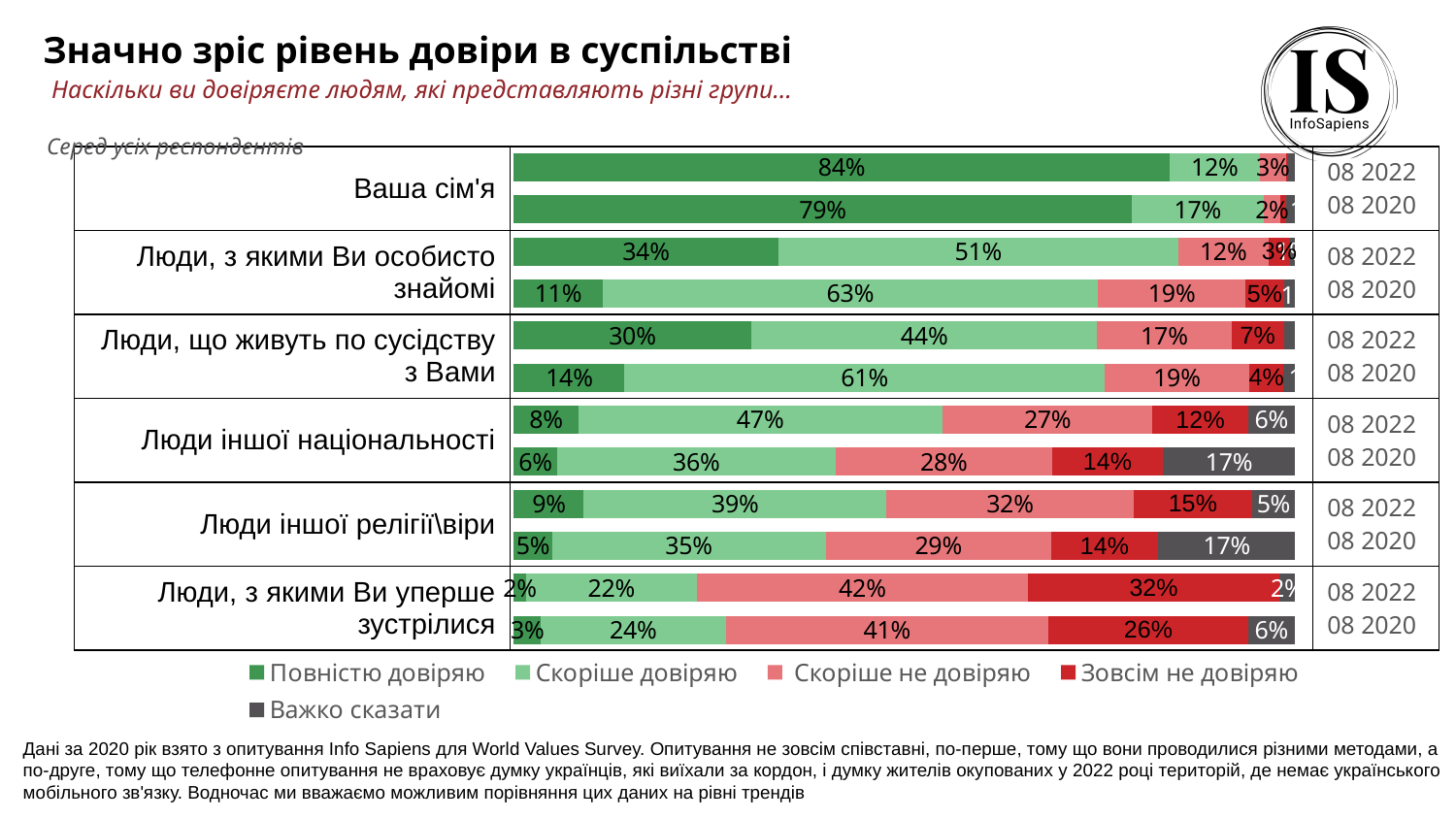
By how many percentage points did the 'Повністю довіряю' share for 'Люди, з якими Ви особисто знайомі' change from 08 2020 (11%) to 08 2022 (34%)? 23 percentage points By how many percentage points did the 'Повністю довіряю' share for 'Люди, що живуть по сусідству з Вами' change from 08 2020 to 08 2022? 16 percentage points What type of chart is shown on the slide? Stacked bar chart What is the 'Скоріше довіряю' value for 'Люди, з якими Ви особисто знайомі' in 08 2022? 51% How many series does the legend list? 5 What is the 'Важко сказати' value for 'Люди іншої національності' in 08 2020? 17% Which is larger: the 'Скоріше не довіряю' share for 'Люди іншої релігії\віри' in 08 2022 or in 08 2020? 08 2022 (32%) How many groups (categories) are shown in the chart? 6 Which group has the highest 'Повністю довіряю' share in 08 2022? Ваша сім'я What is the 'Зовсім не довіряю' value for 'Люди, з якими Ви уперше зустрілися' in 08 2022? 32% What share of respondents in 08 2022 fully trust (Повністю довіряю) their family (Ваша сім'я)? 84% What share of respondents in 08 2020 fully trusted (Повністю довіряю) their family (Ваша сім'я)? 79%